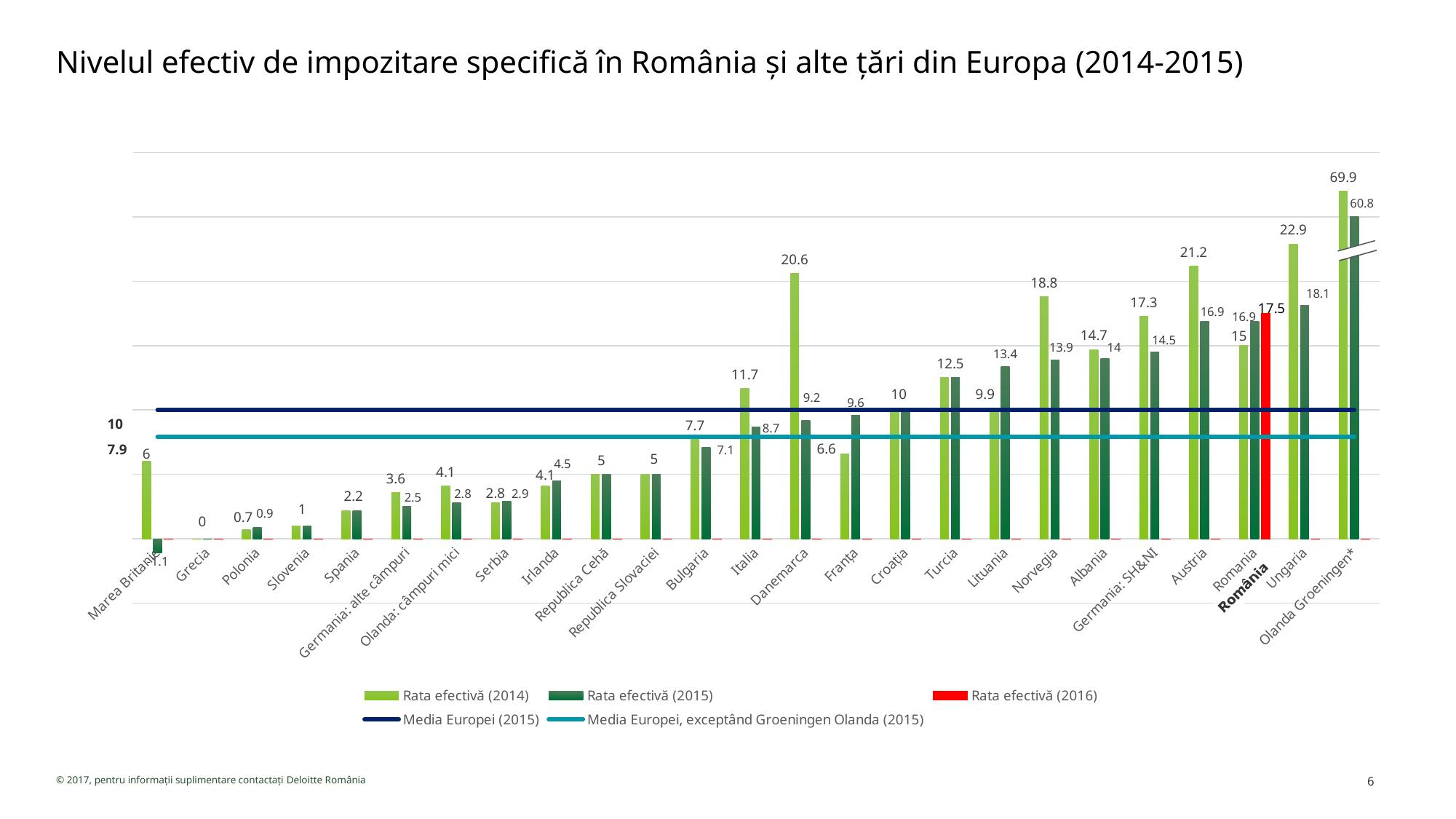
What colour is used for the Rata efectivă (2016) series in the legend? red How many entries does the legend list? 5 What is the Rata efectivă (2016) value for Romania? 17.5 What value is shown for the Media Europei, exceptând Groeningen Olanda (2015) line? 7.9 What is the difference between the Rata efectivă (2014) and Rata efectivă (2015) values for Ungaria? 4.8 Which is larger, the Rata efectivă (2014) value for Danemarca or for Austria? Austria What value is shown for the Media Europei (2015) line? 10 What is the Rata efectivă (2015) value for Norvegia? 13.9 What kind of chart is shown on the slide? combination bar and line chart Which country has the highest Rata efectivă (2014) value? Olanda Groeningen* How many countries/regions are shown on the x axis? 25 What is the Rata efectivă (2014) value for Olanda Groeningen*? 69.9